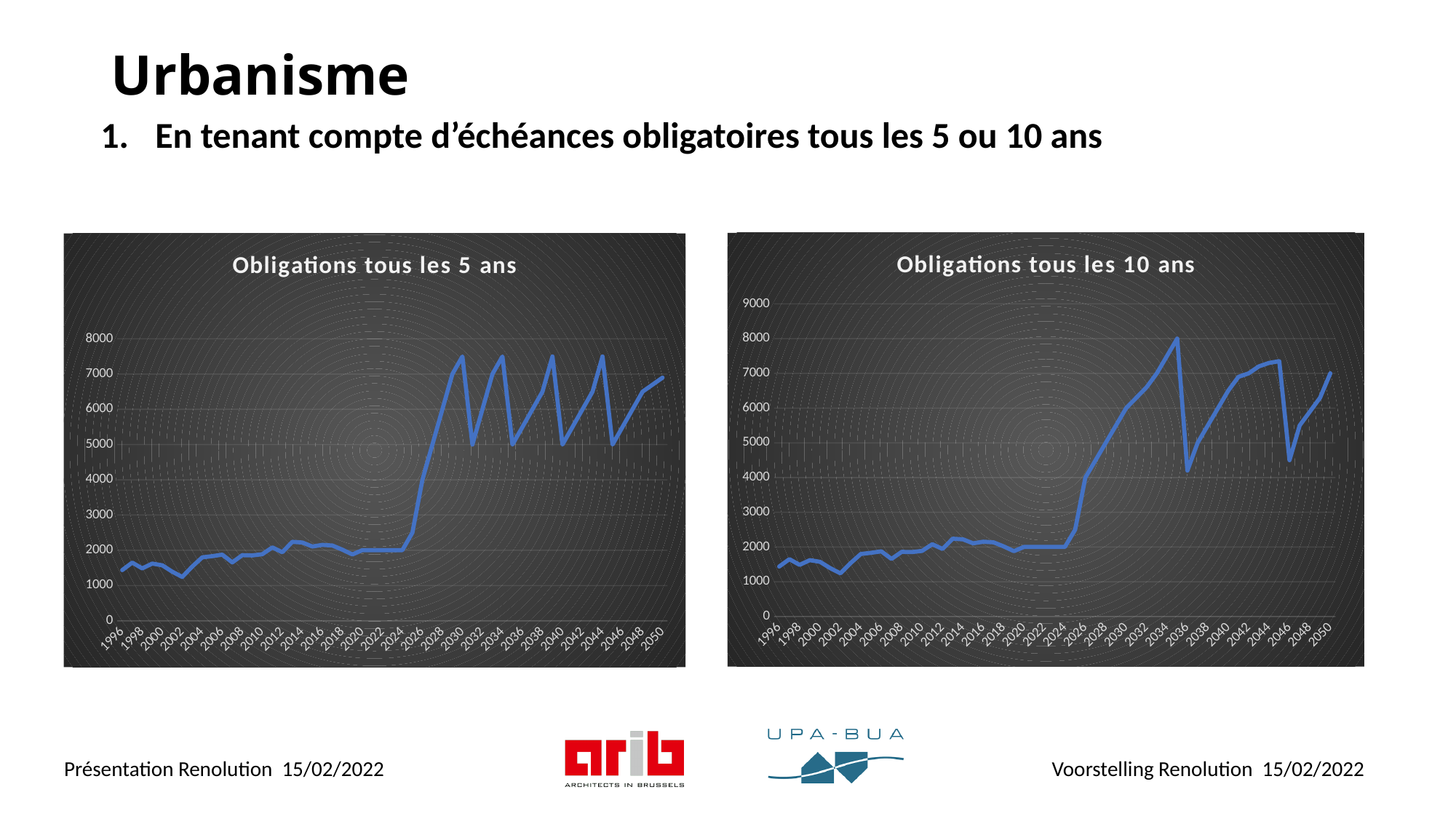
In the left chart 'Obligations tous les 5 ans', is the value for 2030 greater or less than 7000? greater In the right chart 'Obligations tous les 10 ans', which year has the highest value? 2035 What kind of chart is the left chart, 'Obligations tous les 5 ans'? line chart In the right chart 'Obligations tous les 10 ans', is the value for 2036 greater or less than 5000? less How many charts are shown on the slide? 2 What is the highest value shown on the vertical axis of the right chart 'Obligations tous les 10 ans'? 9000 In the left chart 'Obligations tous les 5 ans', what is the first year shown on the horizontal axis? 1996 In the right chart 'Obligations tous les 10 ans', do the values rise or fall between 2024 and 2034? rise In the left chart 'Obligations tous les 5 ans', do the values rise or fall between 2030 and 2032? fall In the right chart 'Obligations tous les 10 ans', is the value for 2034 greater or less than 7000? greater What is the title of the right chart? Obligations tous les 10 ans